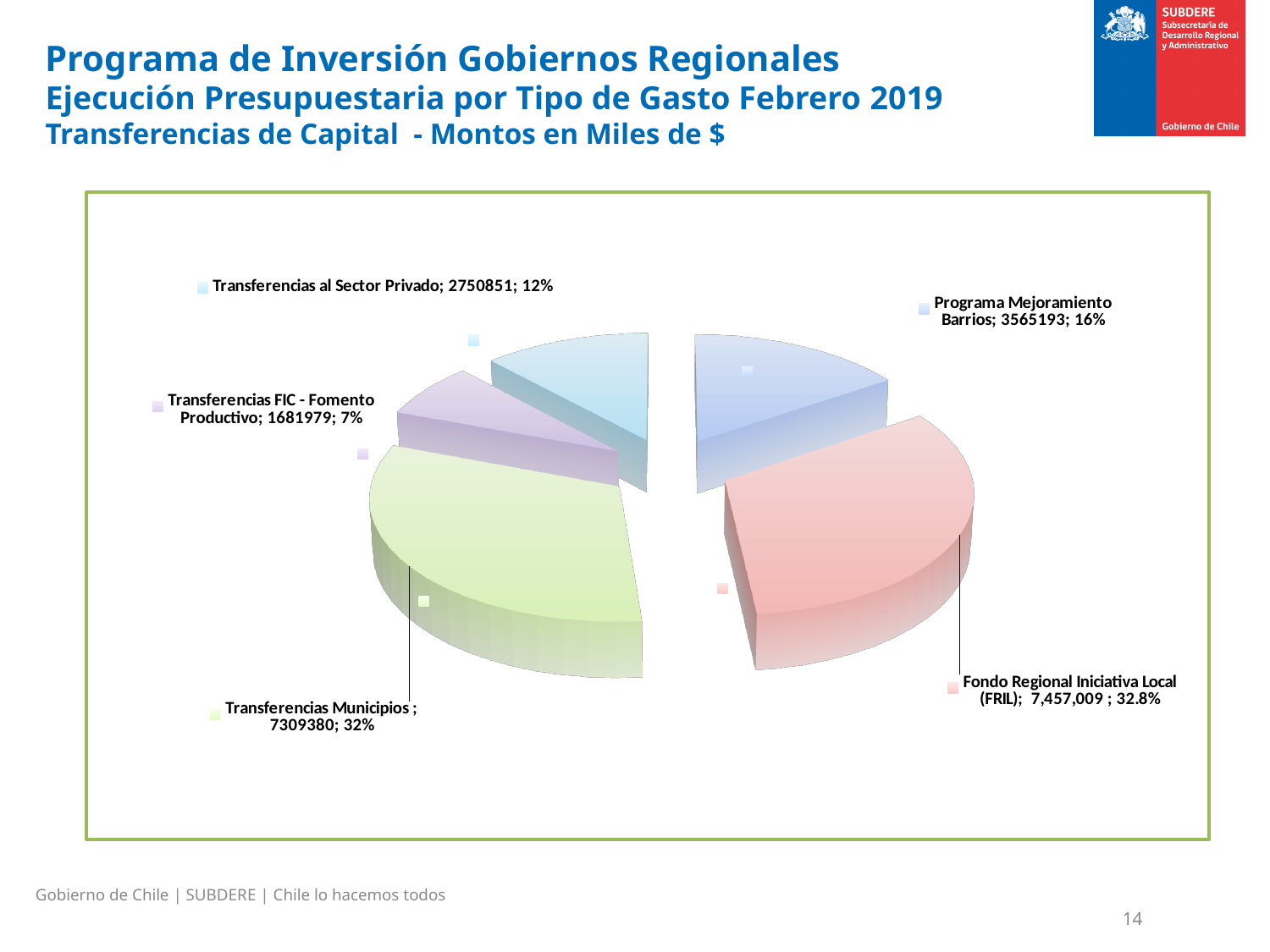
What is the value for Transferencias Municipios? 7309380 What is the value for Programa Mejoramiento Barrios? 3565193 What kind of chart is shown on the slide? Pie chart Which category has the largest value? Fondo Regional Iniciativa Local (FRIL) Which is larger, the value for Transferencias al Sector Privado or the value for Transferencias FIC - Fomento Productivo? Transferencias al Sector Privado What share of the pie does Transferencias al Sector Privado represent? 12% What share of the pie does Fondo Regional Iniciativa Local (FRIL) represent? 32.8% How many slices does the pie chart have? 5 What is the value for Transferencias FIC - Fomento Productivo? 1681979 What is the value for Fondo Regional Iniciativa Local (FRIL)? 7,457,009 Which category has the smallest value? Transferencias FIC - Fomento Productivo What is the difference between the values for Programa Mejoramiento Barrios and Transferencias al Sector Privado? 814342